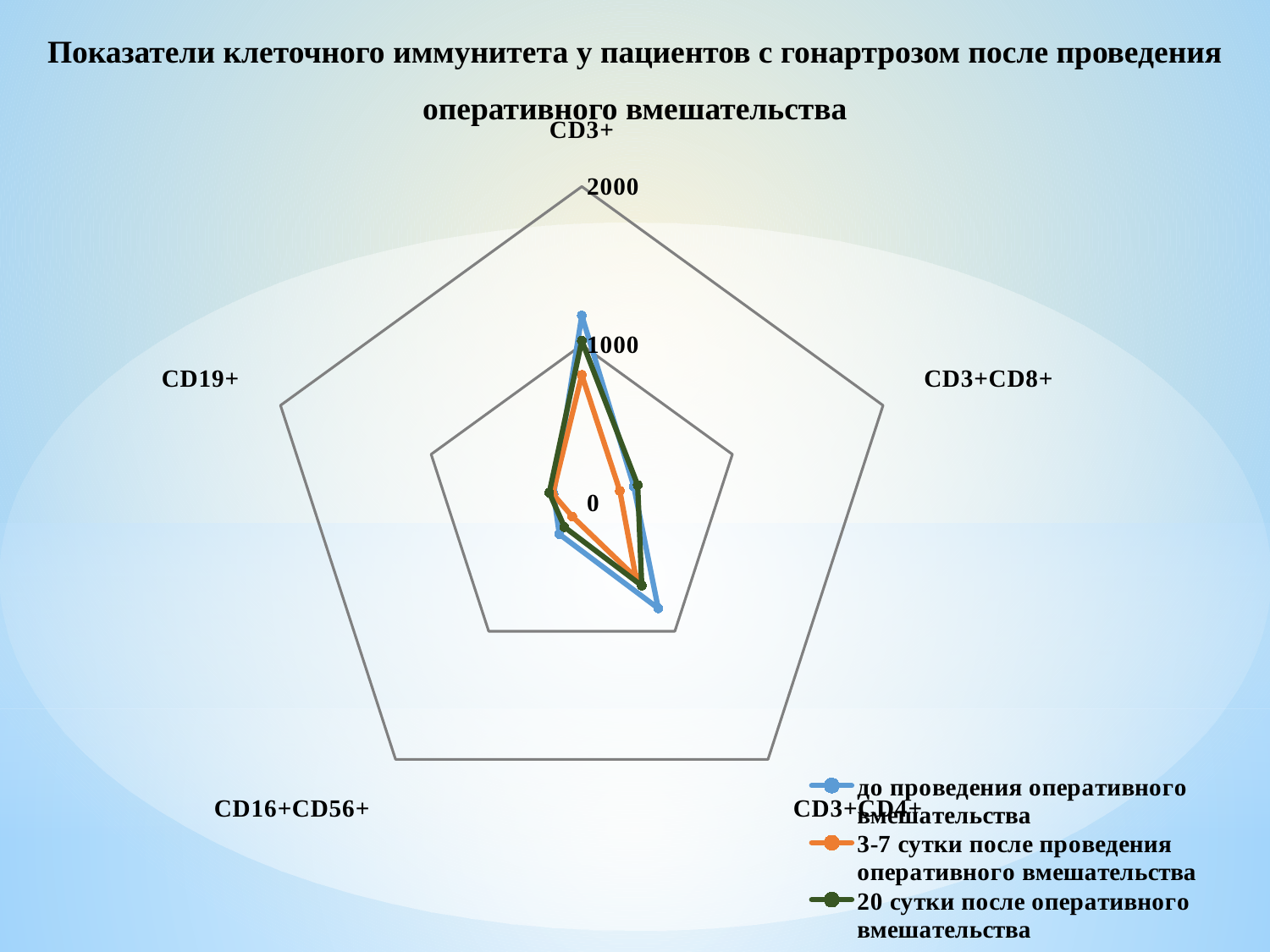
Which series has the highest CD3+ value? до проведения оперативного вмешательства For the series 'до проведения оперативного вмешательства', which category has the highest value? CD3+ How many categories (axes) does the radar chart have? 5 Is the CD19+ value for '20 сутки после оперативного вмешательства' greater or less than 1000? less Which colour represents the series '3-7 сутки после проведения оперативного вмешательства'? orange Which series has the higher CD3+ value: 'до проведения оперативного вмешательства' or '3-7 сутки после проведения оперативного вмешательства'? до проведения оперативного вмешательства Is the CD3+CD8+ value for 'до проведения оперативного вмешательства' greater or less than 1000? less Is the CD3+ value for 'до проведения оперативного вмешательства' greater or less than 1000? greater What is the maximum value shown on the radar chart's axis scale? 2000 How many series does the legend list? 3 What kind of chart is shown on the slide? radar chart